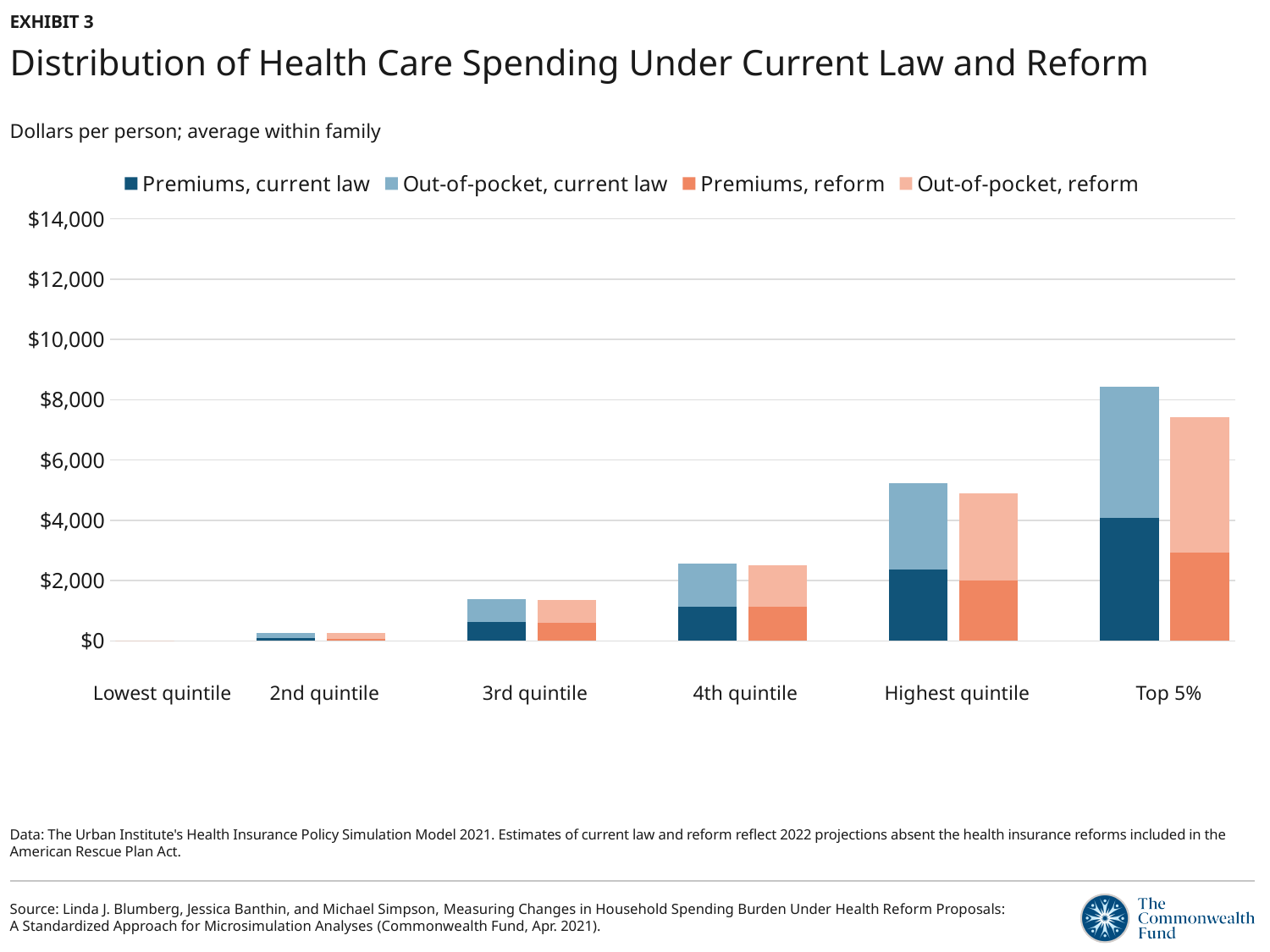
Is the total reform spending for the Top 5% greater or less than $8,000? less What unit does the subtitle say the values are measured in? Dollars per person; average within family How many series does the legend list? 4 Is the total current-law spending for the Highest quintile greater or less than $4,000? greater How many income categories are shown along the x axis? 6 Which category has the highest total spending under current law? Top 5% Do total spending values rise or fall moving from the Lowest quintile to the Top 5%? Rise Which category has the lowest total spending under current law? Lowest quintile What kind of chart is shown on the slide? Stacked bar chart Is the total current-law spending for the Top 5% greater or less than $8,000? greater For the Top 5%, which is larger: total spending under current law or under reform? Current law